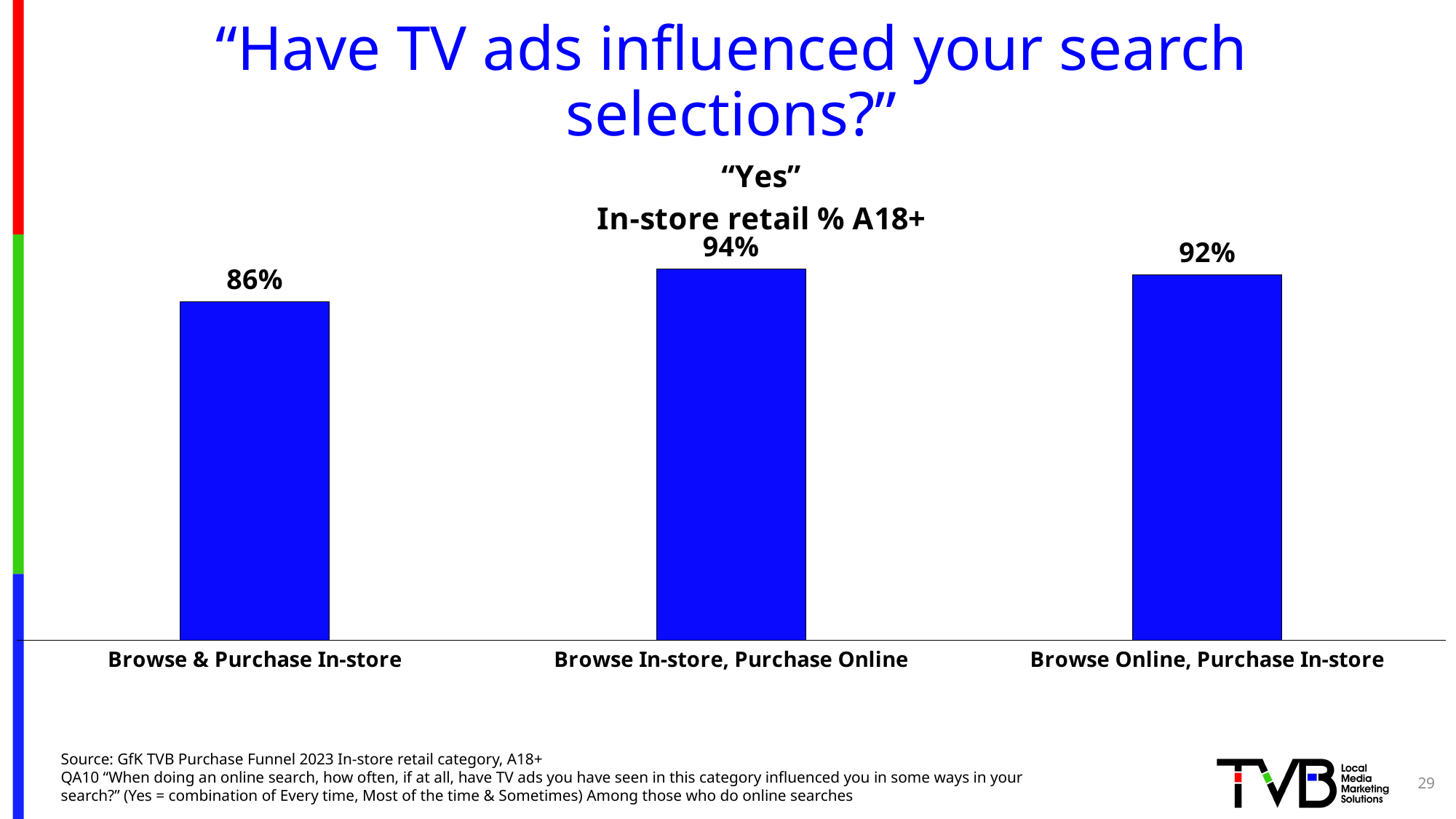
What is the difference between the values for Browse In-store, Purchase Online and Browse & Purchase In-store? 8% How many categories are shown in the chart? 3 What kind of chart is shown on the slide? Bar chart What is the subtitle of the chart below the word "Yes"? In-store retail % A18+ What colour are the bars in the chart? Blue What is the value shown for Browse Online, Purchase In-store? 92% Which category has the lowest percentage? Browse & Purchase In-store What is the value shown for Browse In-store, Purchase Online? 94% Which category has the highest percentage? Browse In-store, Purchase Online What percentage of Browse & Purchase In-store respondents said TV ads influenced their search selections? 86% Which is larger: the value for Browse Online, Purchase In-store or the value for Browse & Purchase In-store? Browse Online, Purchase In-store What is the difference between the values for Browse Online, Purchase In-store and Browse In-store, Purchase Online? 2%